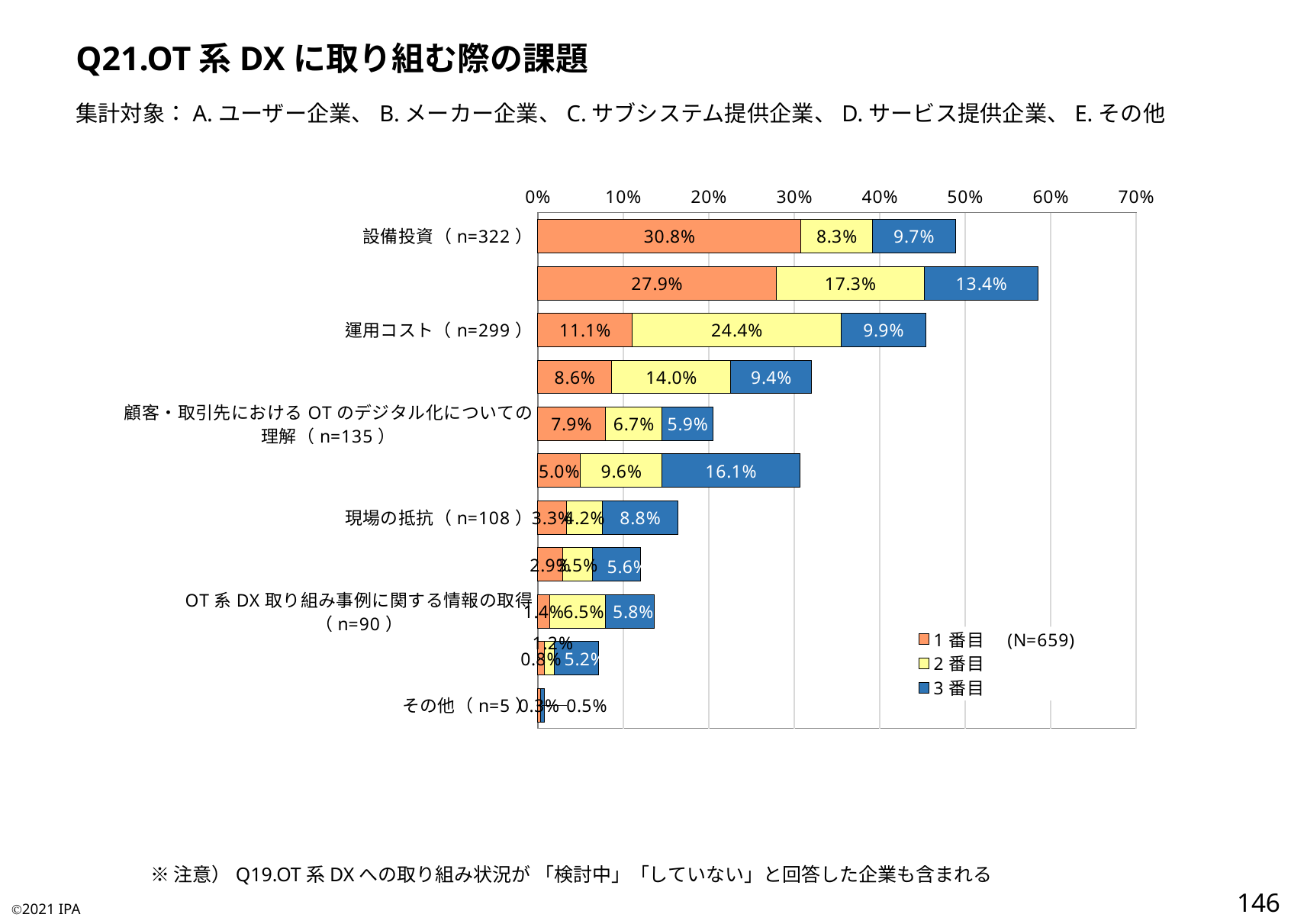
Which is larger: the 3番目 value for 設備投資 (n=322) or the 3番目 value for 運用コスト (n=299)? 運用コスト (n=299) What is the total of the stacked bar for 設備投資 (n=322)? 48.8% What is the value of the 2番目 series for OT系DX取り組み事例に関する情報の取得 (n=90)? 6.5% What kind of chart is shown on the slide? Stacked bar chart Is the total length of the stacked bar for 設備投資 (n=322) greater or less than 40%? greater How many series does the legend list? 3 What is the value of the 2番目 series for 運用コスト (n=299)? 24.4% What is the total of the stacked bar for 顧客・取引先におけるOTのデジタル化についての理解 (n=135)? 20.5% What is the value of the 1番目 series for 設備投資 (n=322)? 30.8% What is the value of the 3番目 series for 現場の抵抗 (n=108)? 8.8% For 設備投資 (n=322), which series has the largest value? 1番目 For 運用コスト (n=299), how much larger is the 2番目 value than the 1番目 value? 13.3%